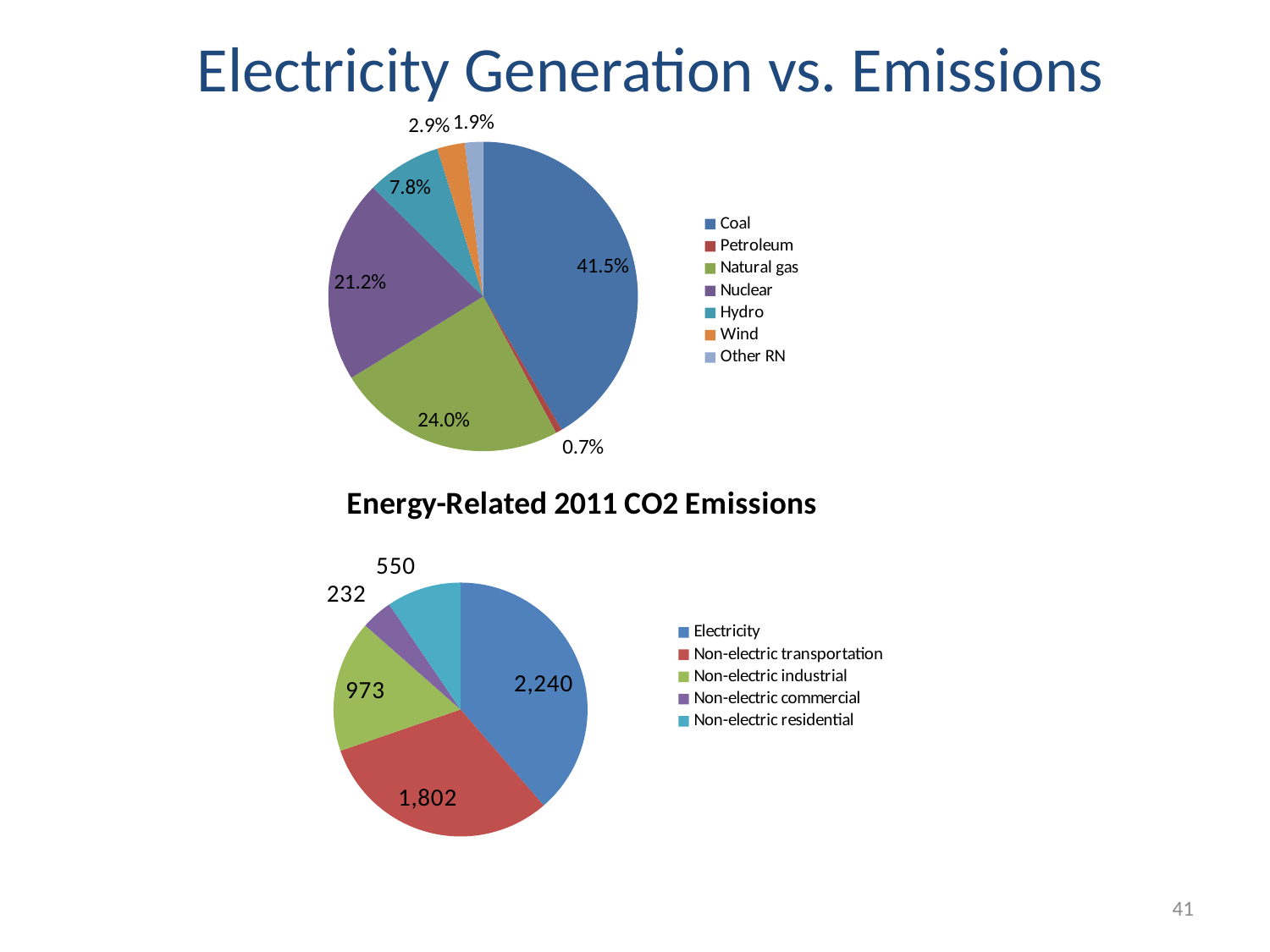
How many categories does the legend of the top pie chart list? 7 In the top pie chart, what percentage is shown for Coal? 41.5% What type of chart is the 'Energy-Related 2011 CO2 Emissions' chart? Pie chart In the 'Energy-Related 2011 CO2 Emissions' chart, what is the value for Electricity? 2,240 In the 'Energy-Related 2011 CO2 Emissions' chart, what is the difference between Electricity and Non-electric transportation? 438 In the 'Energy-Related 2011 CO2 Emissions' chart, which is larger: Non-electric industrial or Non-electric residential? Non-electric industrial In the top pie chart, which source has the smallest slice? Petroleum In the 'Energy-Related 2011 CO2 Emissions' chart, what is the value for Non-electric commercial? 232 In the top pie chart, what is the difference in percentage points between Coal and Natural gas? 17.5 In the 'Energy-Related 2011 CO2 Emissions' chart, which category has the largest value? Electricity In the top pie chart, what percentage is shown for Nuclear? 21.2% In the top pie chart, which source has the largest slice? Coal